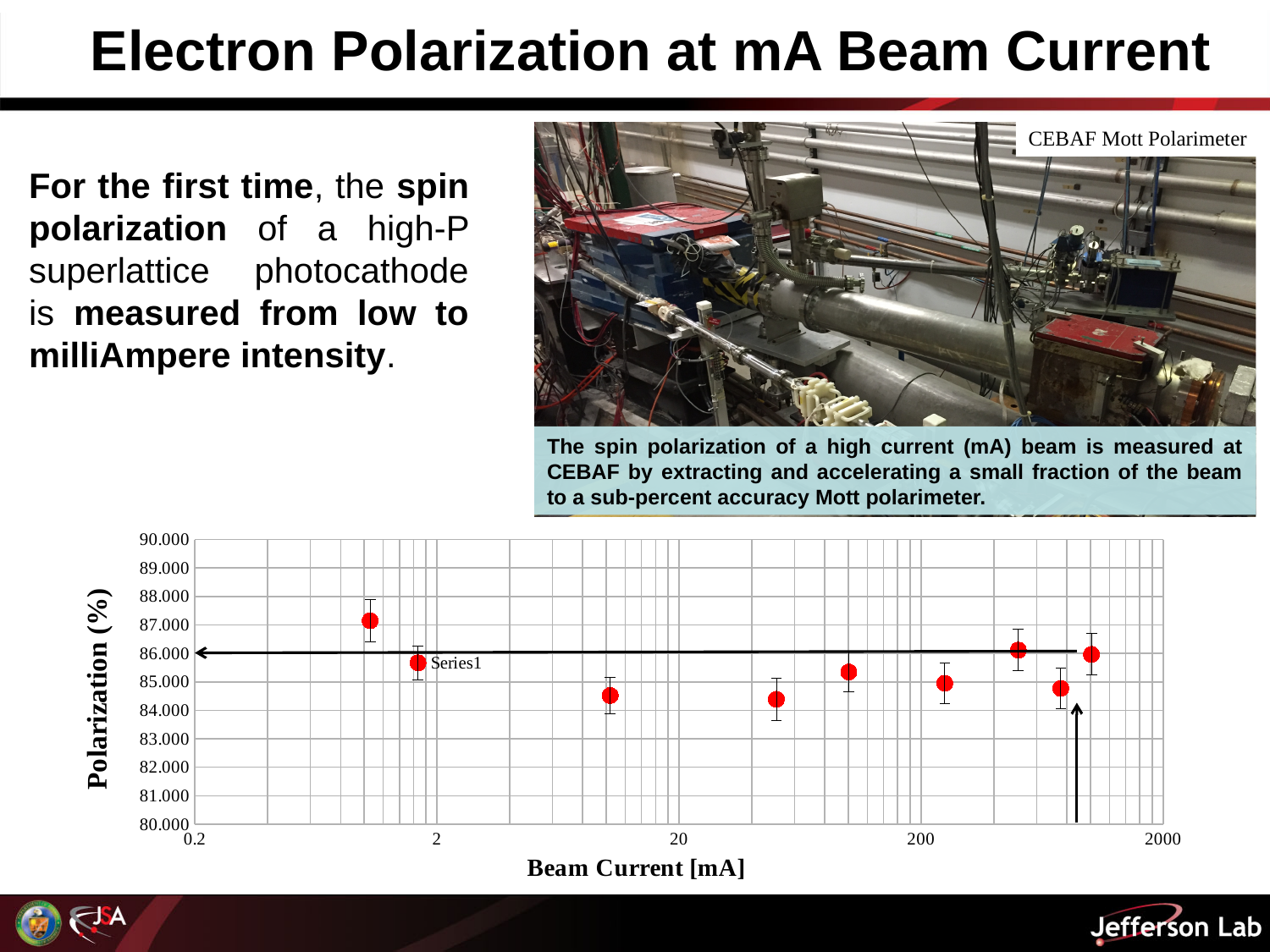
Is the polarization of the second data point (just below 2 mA) greater or less than 86.000? less What is the label of the x axis of the chart? Beam Current [mA] What is the label of the y axis of the chart? Polarization (%) Does the polarization rise or fall from the leftmost data point to the data point near 10 mA? fall Is the polarization of the leftmost data point greater or less than 86.000? greater What is the name of the series shown in the chart? Series1 Which has the higher polarization: the leftmost data point or the data point near 10 mA? The leftmost data point Which data point has the highest polarization value? The leftmost point (lowest beam current, near 1 mA) How many data points are plotted in the chart? 9 Is the polarization of the rightmost data point greater or less than 85.000? greater What kind of chart is shown at the bottom of the slide? Scatter chart